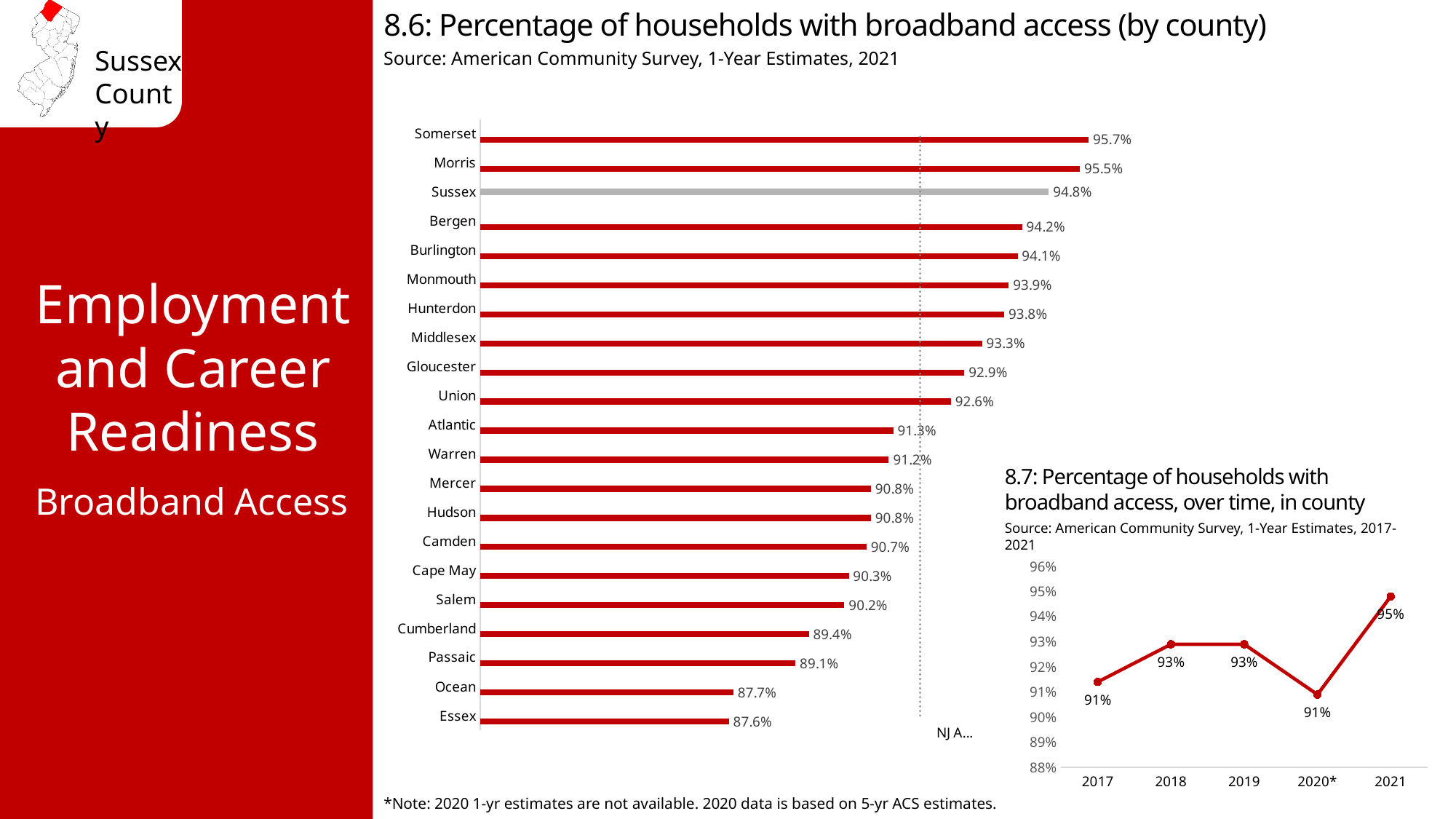
In chart 8.7, which year has the lowest value? 2017 and 2020* (both 91%) In chart 8.6, which county has the highest percentage of households with broadband access? Somerset In chart 8.6, what is the difference between Somerset's and Essex's percentages? 8.1% In chart 8.7, what is the percentage of households with broadband access in 2021? 95% What type of chart is chart 8.6? Bar chart In chart 8.6, which county has a higher value, Bergen or Burlington? Bergen In chart 8.6, which county's bar is shown in grey rather than red? Sussex In chart 8.6, what is the percentage of households with broadband access in Sussex County? 94.8% In chart 8.6, what is the value for Cumberland? 89.4% In chart 8.6, which county has the lowest percentage of households with broadband access? Essex How many counties are shown in chart 8.6? 21 How many data points are plotted in chart 8.7? 5